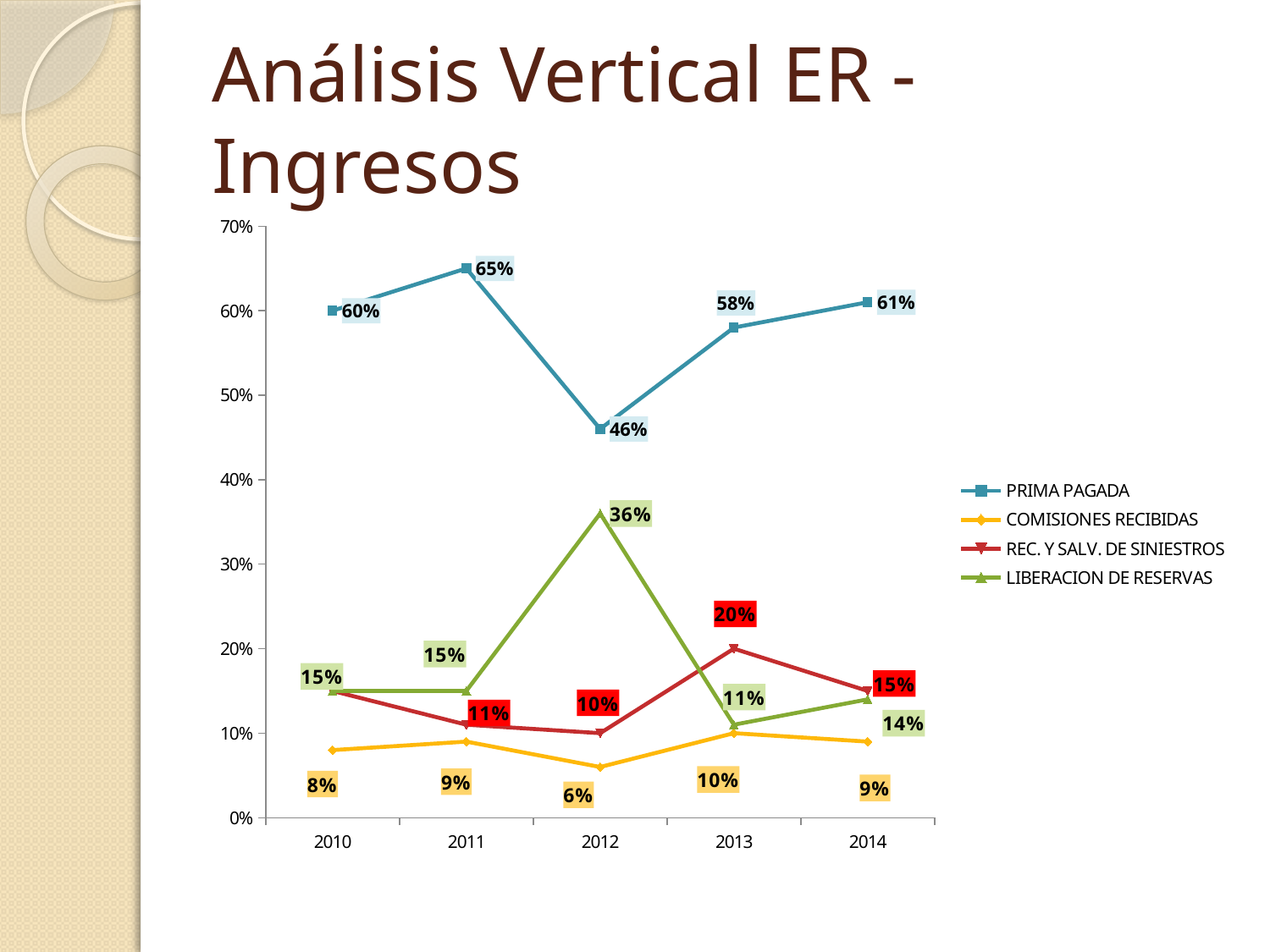
In which year is PRIMA PAGADA lowest? 2012 How many series does the legend list? 4 What kind of chart is shown on the slide? Line chart In 2013, which is larger: REC. Y SALV. DE SINIESTROS or LIBERACION DE RESERVAS? REC. Y SALV. DE SINIESTROS Does PRIMA PAGADA rise or fall from 2012 to 2014? Rises What is the value for COMISIONES RECIBIDAS in 2012? 6% What is the difference between the PRIMA PAGADA values for 2011 and 2012? 19 percentage points In which year is PRIMA PAGADA highest? 2011 What is the value for REC. Y SALV. DE SINIESTROS in 2013? 20% What is the value for PRIMA PAGADA in 2012? 46% What is the value for LIBERACION DE RESERVAS in 2012? 36% How many years are shown on the x axis? 5